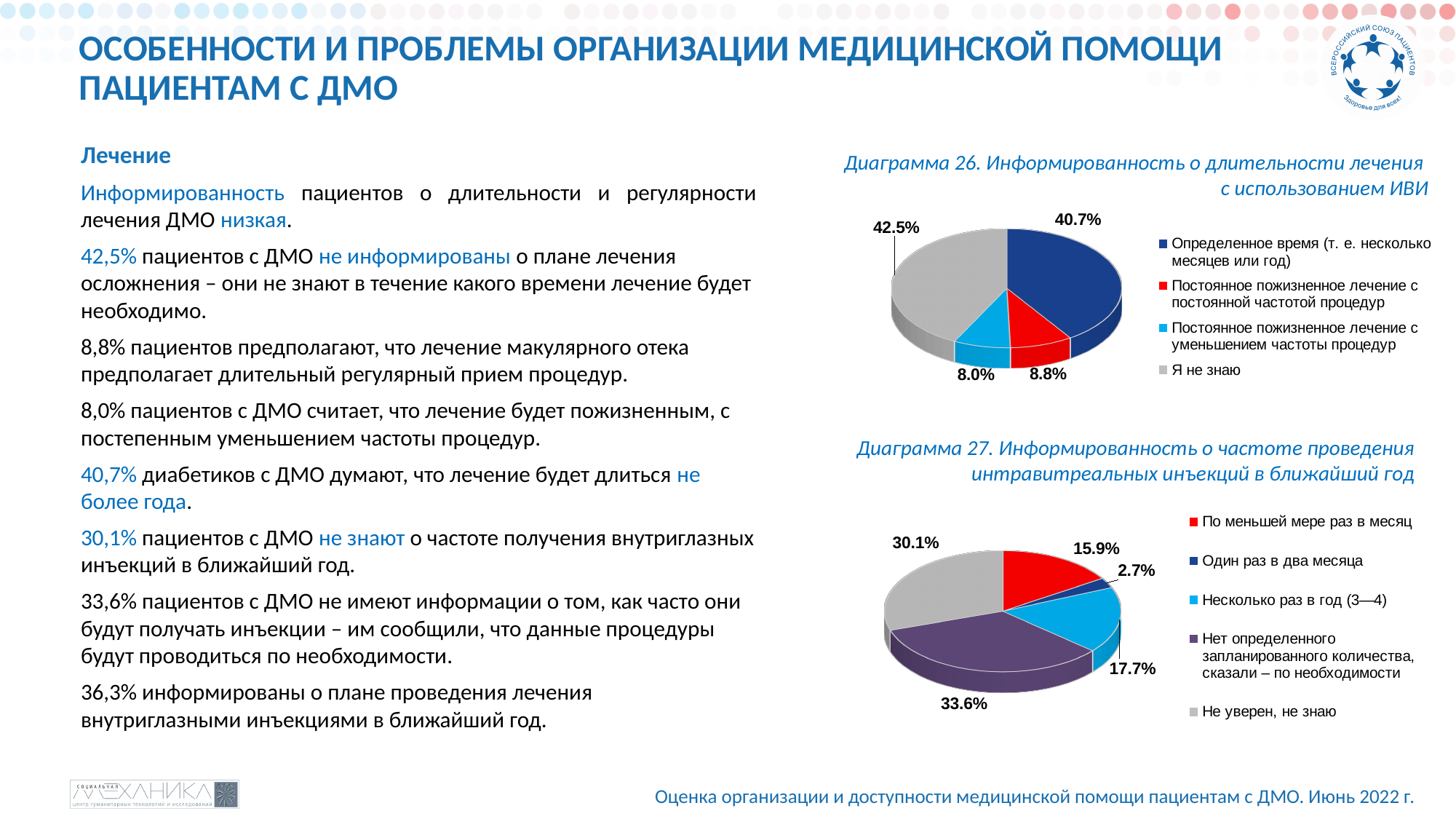
In Diagram 26, which category has the smallest share? Постоянное пожизненное лечение с уменьшением частоты процедур In Diagram 27, what is the difference between the "Нет определенного запланированного количества" share and the "Не уверен, не знаю" share? 3.5% In Diagram 27, what colour is the slice for "Не уверен, не знаю"? Grey In Diagram 26 (Информированность о длительности лечения с использованием ИВИ), what share of patients answered "Я не знаю"? 42.5% In Diagram 27, which category has the largest share? Нет определенного запланированного количества, сказали – по необходимости How many slices does the pie in Diagram 27 have? 5 In Diagram 27, what share of patients answered "Один раз в два месяца"? 2.7% In Diagram 26, what percentage corresponds to "Определенное время (т. е. несколько месяцев или год)"? 40.7% In Diagram 27, which is larger: "По меньшей мере раз в месяц" or "Несколько раз в год (3—4)"? Несколько раз в год (3—4) How many categories does the legend of Diagram 26 list? 4 In Diagram 26, what is the difference between the "Я не знаю" share and the "Определенное время" share? 1.8% What type of chart is Diagram 27 (Информированность о частоте проведения интравитреальных инъекций в ближайший год)? Pie chart